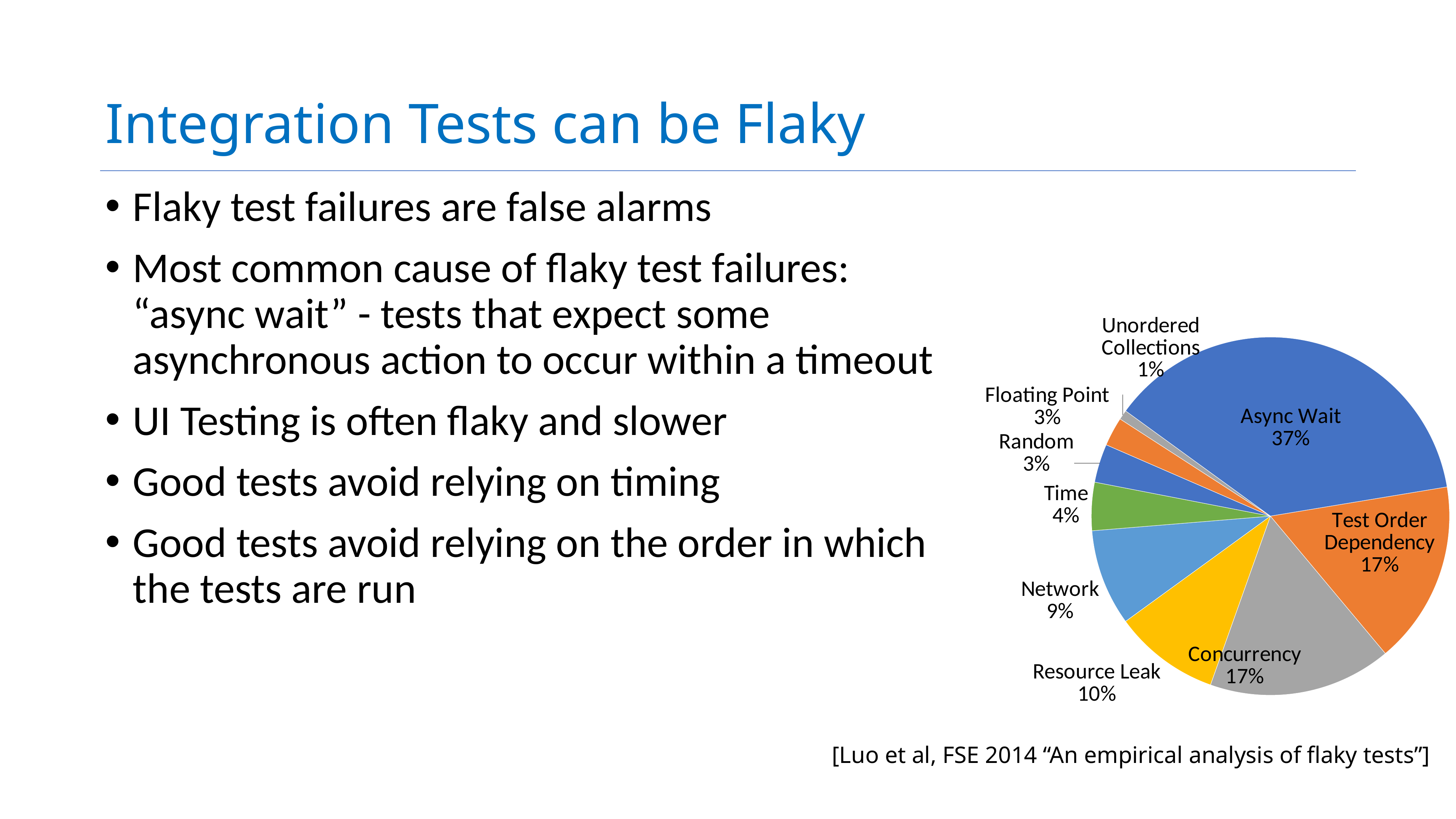
What kind of chart is shown on the slide? pie chart What percentage is shown for Time? 4% Which category has the smallest slice of the pie? Unordered Collections What colour is the Async Wait slice? blue What percentage is shown for Network? 9% What percentage is shown for Unordered Collections? 1% Which category has the largest slice of the pie? Async Wait What share of the pie does Async Wait account for? 37% What is the difference in percentage points between Async Wait and Test Order Dependency? 20 How many categories are shown in the pie chart? 9 What percentage is shown for Resource Leak? 10% Which is larger, the share for Resource Leak or the share for Network? Resource Leak